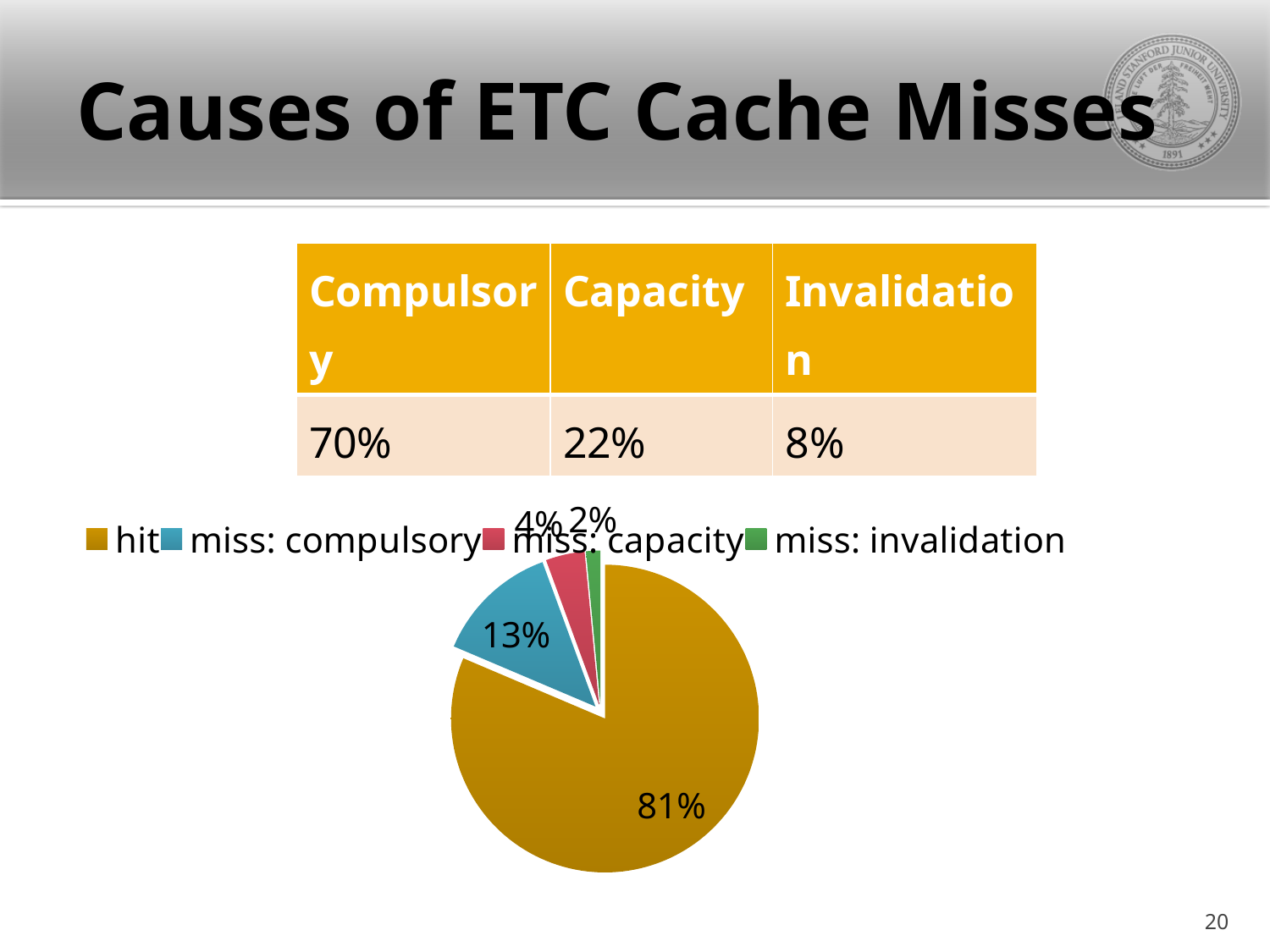
What share of the pie chart is "miss: compulsory"? 13% How many slices does the pie chart have? 4 Which is larger in the pie chart, "miss: compulsory" or "miss: capacity"? miss: compulsory What is the difference in percentage points between the "hit" slice and the "miss: compulsory" slice? 68 Which slice of the pie chart is the smallest? miss: invalidation What kind of chart is shown on the slide? pie chart What share of the pie chart is "miss: invalidation"? 2% What share of the pie chart is "miss: capacity"? 4% Which slice of the pie chart is the largest? hit What colour is the "hit" slice in the pie chart? gold How many entries does the pie chart's legend list? 4